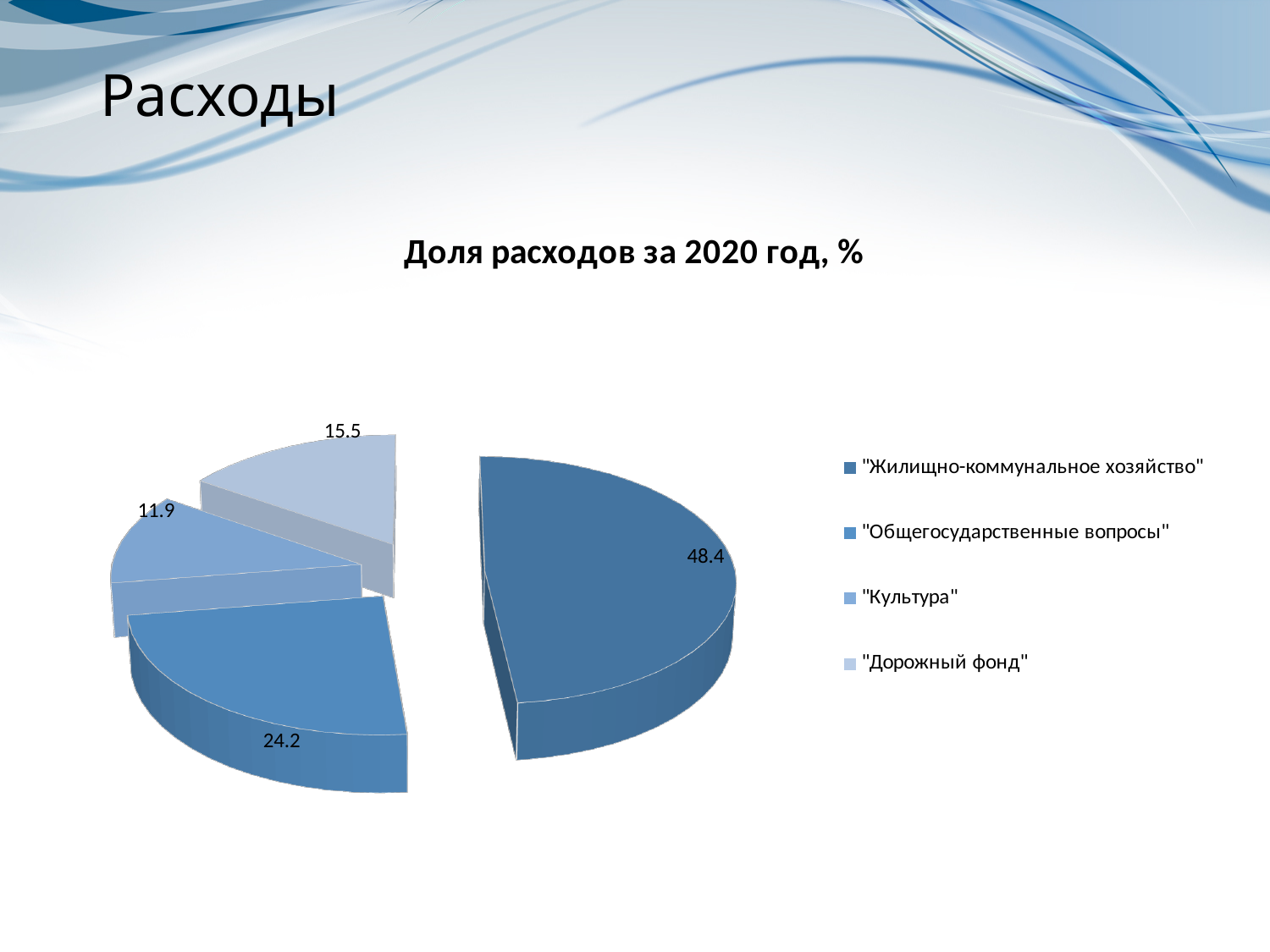
What is the value for "Культура"? 11.9 Which category has the smallest share of the pie? "Культура" What is the value for "Дорожный фонд"? 15.5 What is the difference between the values for "Жилищно-коммунальное хозяйство" and "Общегосударственные вопросы"? 24.2 What is the value for "Жилищно-коммунальное хозяйство"? 48.4 What kind of chart is shown on the slide? pie chart How many entries does the legend list? 4 What is the value for "Общегосударственные вопросы"? 24.2 What is the title of the chart? Доля расходов за 2020 год, % Which is larger, the value for "Дорожный фонд" or the value for "Культура"? "Дорожный фонд" How many slices does the pie chart have? 4 Which category has the largest share of the pie? "Жилищно-коммунальное хозяйство"